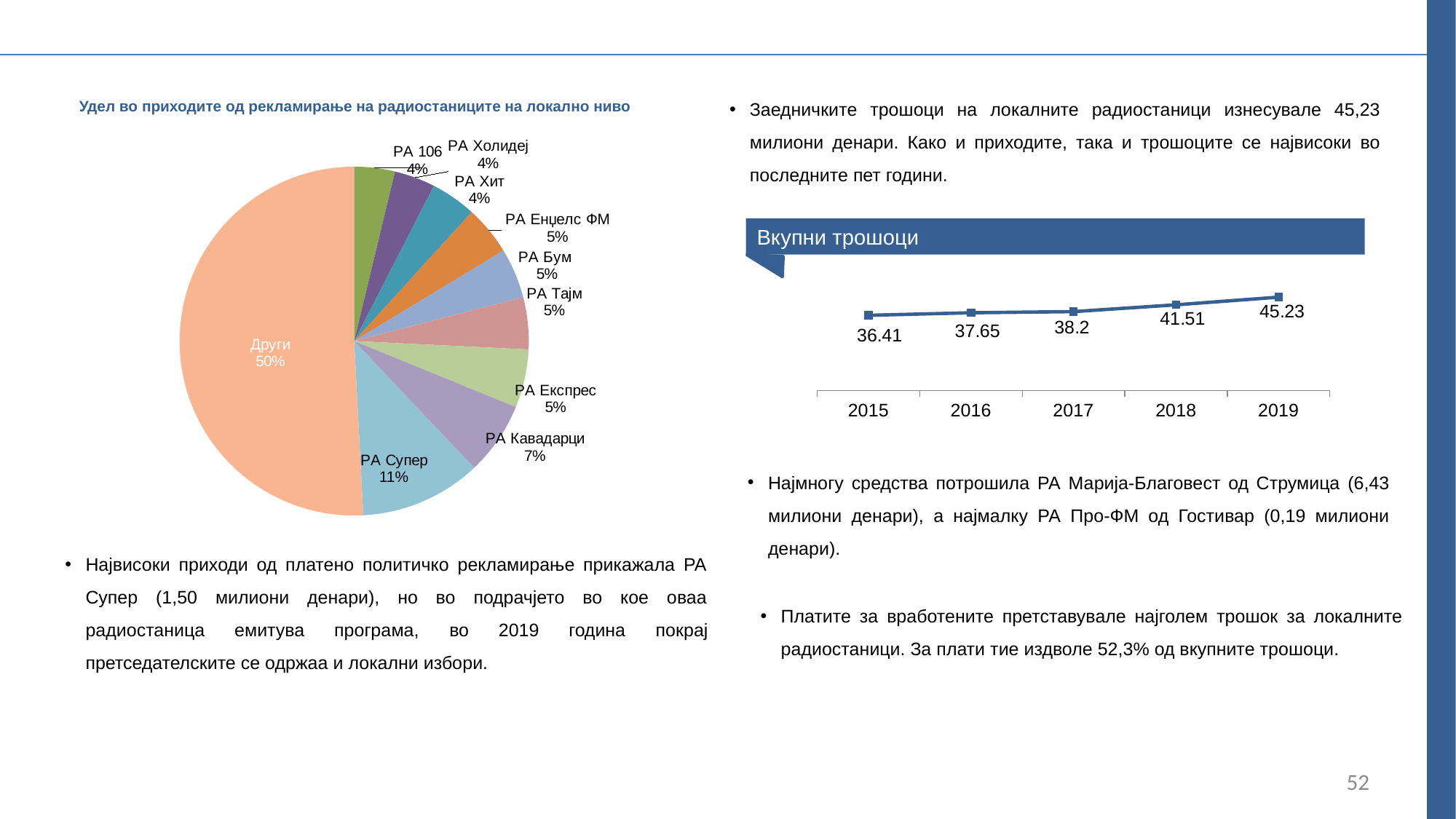
In the pie chart 'Удел во приходите од рекламирање на радиостаниците на локално ниво', what share does РА Супер have? 11% In the chart 'Вкупни трошоци', what is the value for 2017? 38.2 In the pie chart 'Удел во приходите од рекламирање на радиостаниците на локално ниво', how many slices are there? 10 In the pie chart 'Удел во приходите од рекламирање на радиостаниците на локално ниво', which is larger: the share of РА Експрес or the share of РА Хит? РА Експрес In the pie chart 'Удел во приходите од рекламирање на радиостаниците на локално ниво', which slice is the largest? Други In the pie chart 'Удел во приходите од рекламирање на радиостаниците на локално ниво', what share does РА Кавадарци have? 7% In the chart 'Вкупни трошоци', what is the value for 2015? 36.41 In the chart 'Вкупни трошоци', do the values rise or fall from 2015 to 2019? Rise In the pie chart 'Удел во приходите од рекламирање на радиостаниците на локално ниво', what is the difference between the shares of РА Супер and РА Кавадарци? 4% In the chart 'Вкупни трошоци', how many data points are plotted? 5 What type of chart is 'Вкупни трошоци'? Line chart In the chart 'Вкупни трошоци', which year has the highest value? 2019